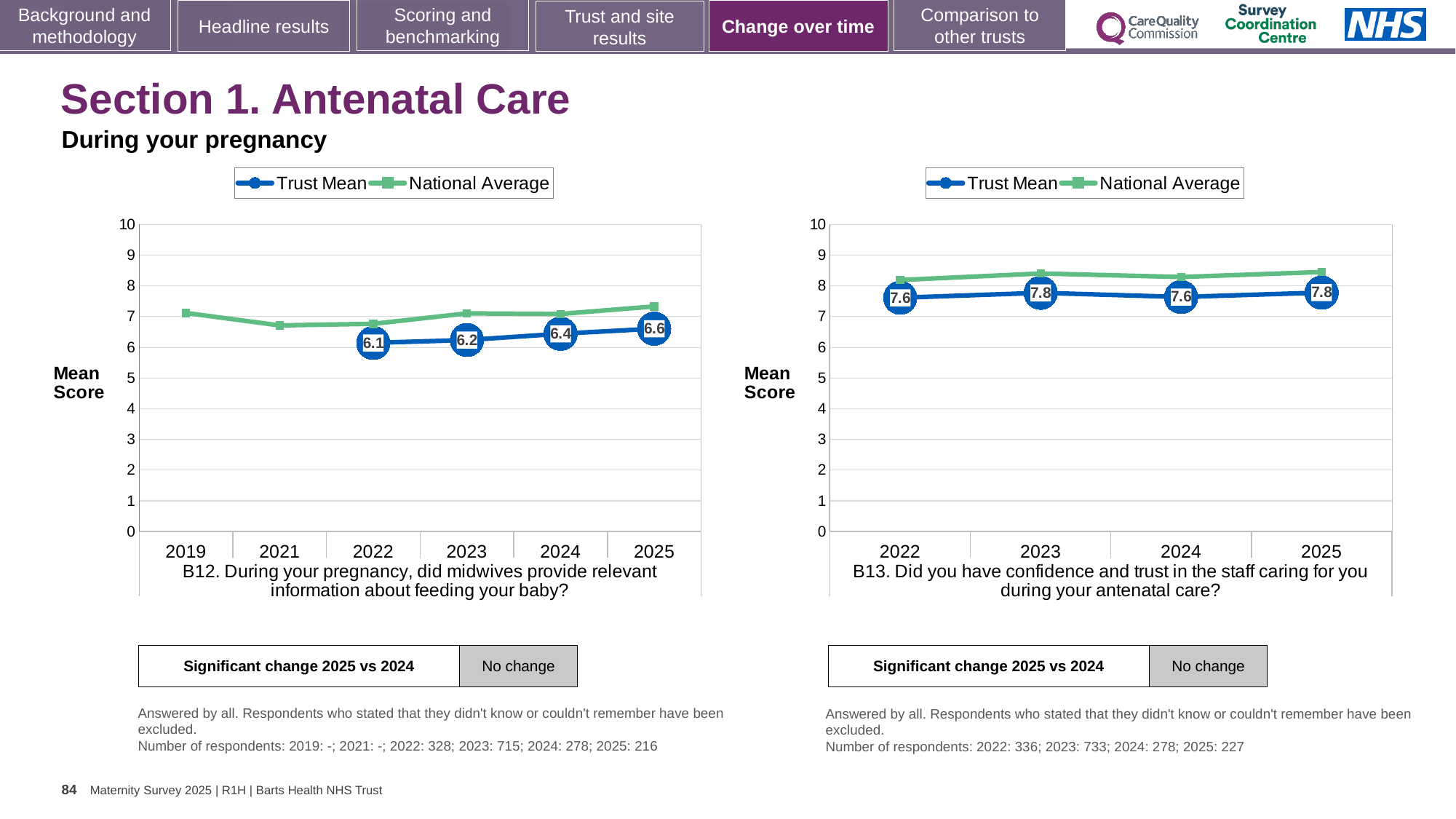
In the B12 chart, is the Trust Mean or the National Average higher in 2025? National Average In the B12 chart, what is the difference between the Trust Mean scores for 2025 and 2022? 0.5 In the B12 chart, what is the Trust Mean score for 2022? 6.1 In the B13 chart, what is the difference between the Trust Mean scores for 2023 and 2022? 0.2 In the B13 chart, is the National Average value for 2025 greater or less than 8? greater What kind of chart is the B13 chart? Line chart How many years are shown on the x axis of the B12 chart? 6 In the B13 chart, what is the Trust Mean score for 2024? 7.6 In the B12 chart, what is the Trust Mean score for 2025? 6.6 In the B12 chart, which year has the lowest Trust Mean score? 2022 In the B13 chart, what is the Trust Mean score for 2023? 7.8 In the B12 chart, which year has the highest Trust Mean score? 2025